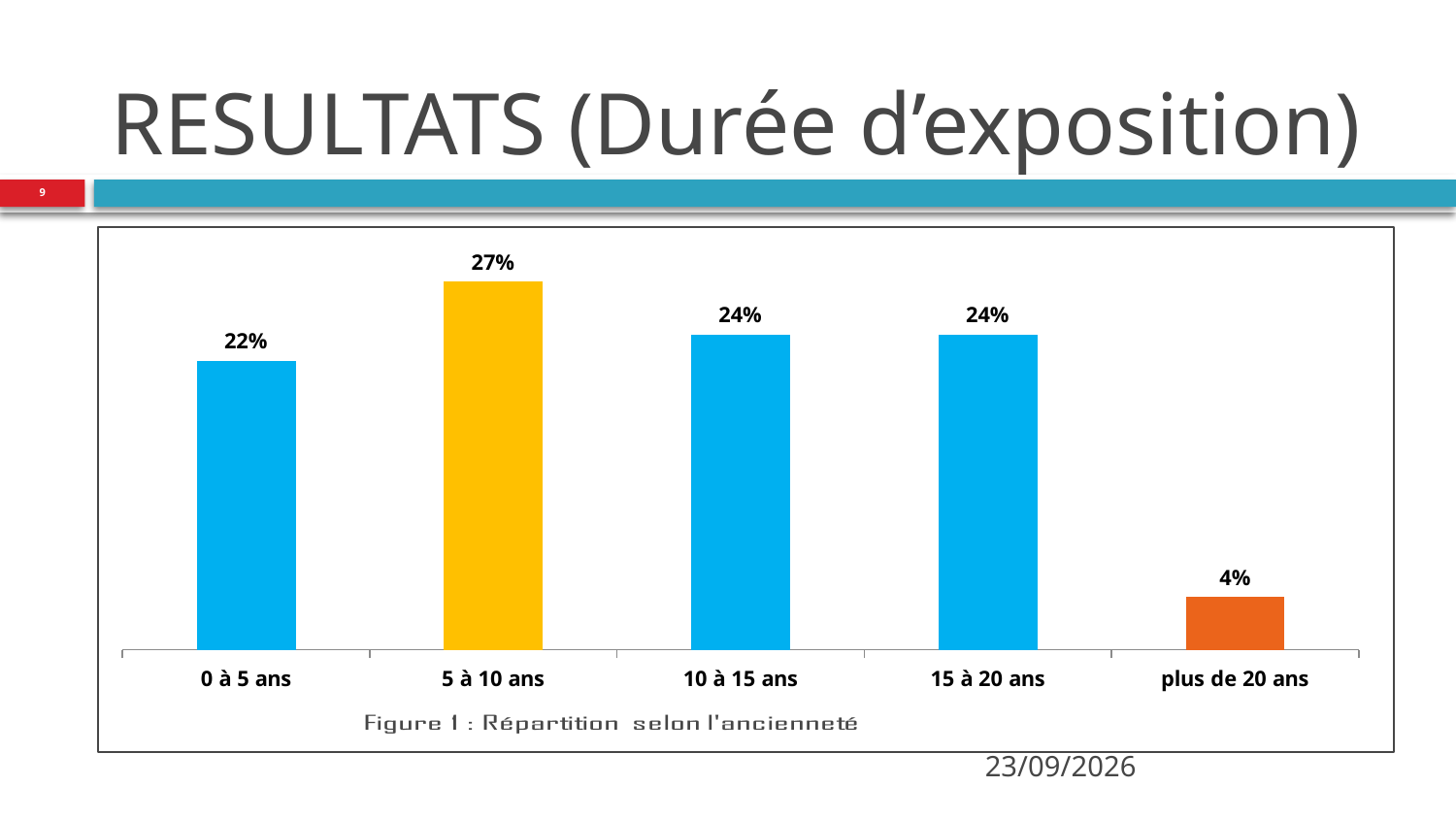
What kind of chart is shown on the slide? Bar chart What is the value for the "5 à 10 ans" category? 27% What is the value for the "15 à 20 ans" category? 24% Which is larger, the value for "0 à 5 ans" or the value for "10 à 15 ans"? 10 à 15 ans What is the difference between the values for "10 à 15 ans" and "plus de 20 ans"? 20% Which category has the lowest value? plus de 20 ans Which category has the highest value? 5 à 10 ans How many categories are shown on the x axis? 5 What is the value for the "0 à 5 ans" category? 22% What is the caption shown below the chart? Figure 1 : Répartition selon l'ancienneté What is the value for the "plus de 20 ans" category? 4% What is the difference between the values for "5 à 10 ans" and "0 à 5 ans"? 5%